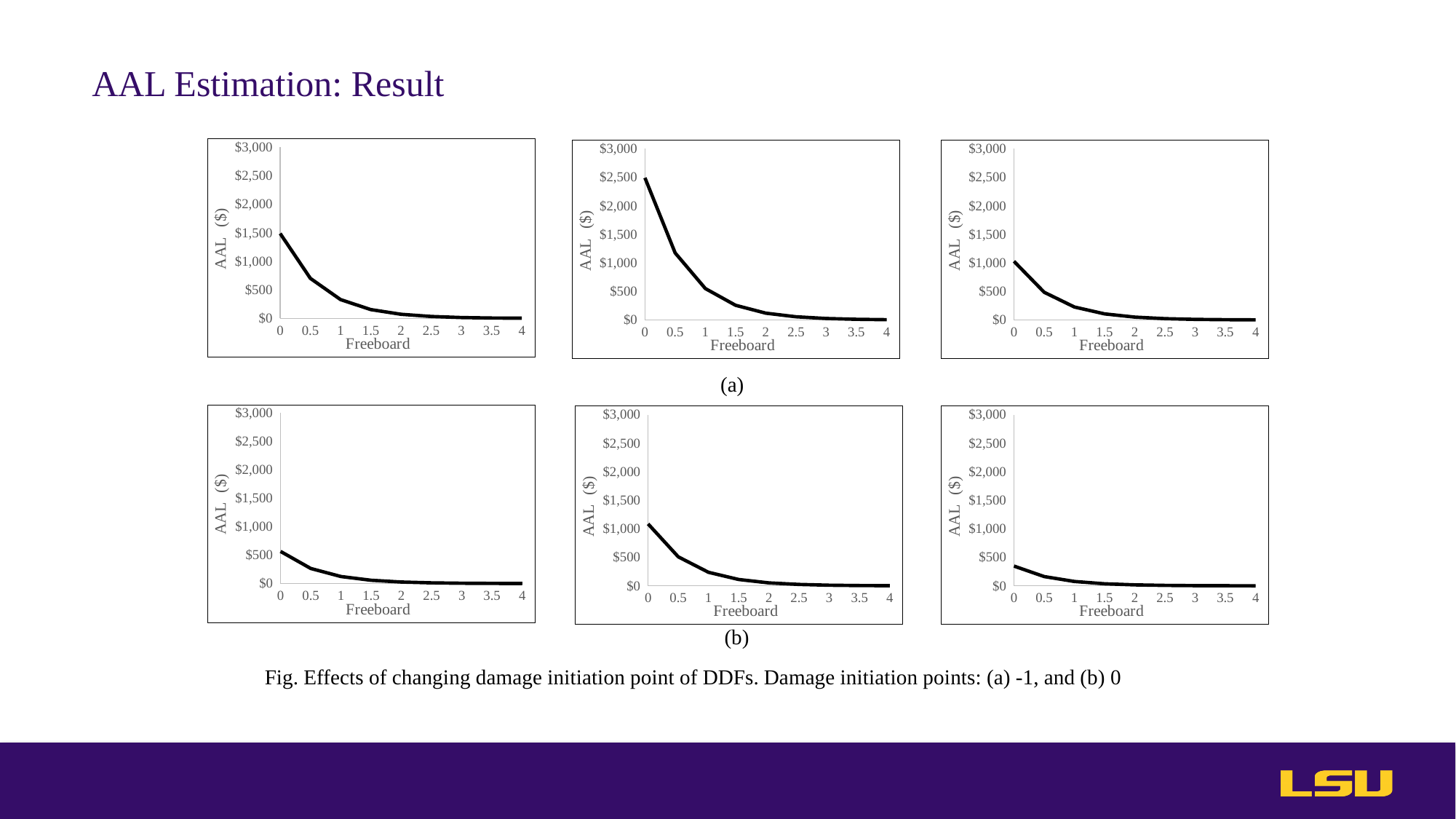
In the top-right chart of panel (a), is the AAL value at freeboard 0 greater or less than $1,500? less What kind of chart is the top-left chart in panel (a)? line chart In the bottom-left chart of panel (b), is the AAL value at freeboard 0 greater or less than $1,000? less In the top-left chart of panel (a), is the AAL value at freeboard 0 greater or less than $1,000? greater In the top-middle chart of panel (a), does the AAL rise or fall as freeboard increases from 0 to 4? fall What is the highest value shown on the y-axis of the top-left chart in panel (a)? $3,000 What is the label on the y-axis of the charts on this slide? AAL ($) At freeboard 0, which chart shows the larger AAL: the top-middle chart of panel (a) or the bottom-middle chart of panel (b)? top-middle chart of panel (a)